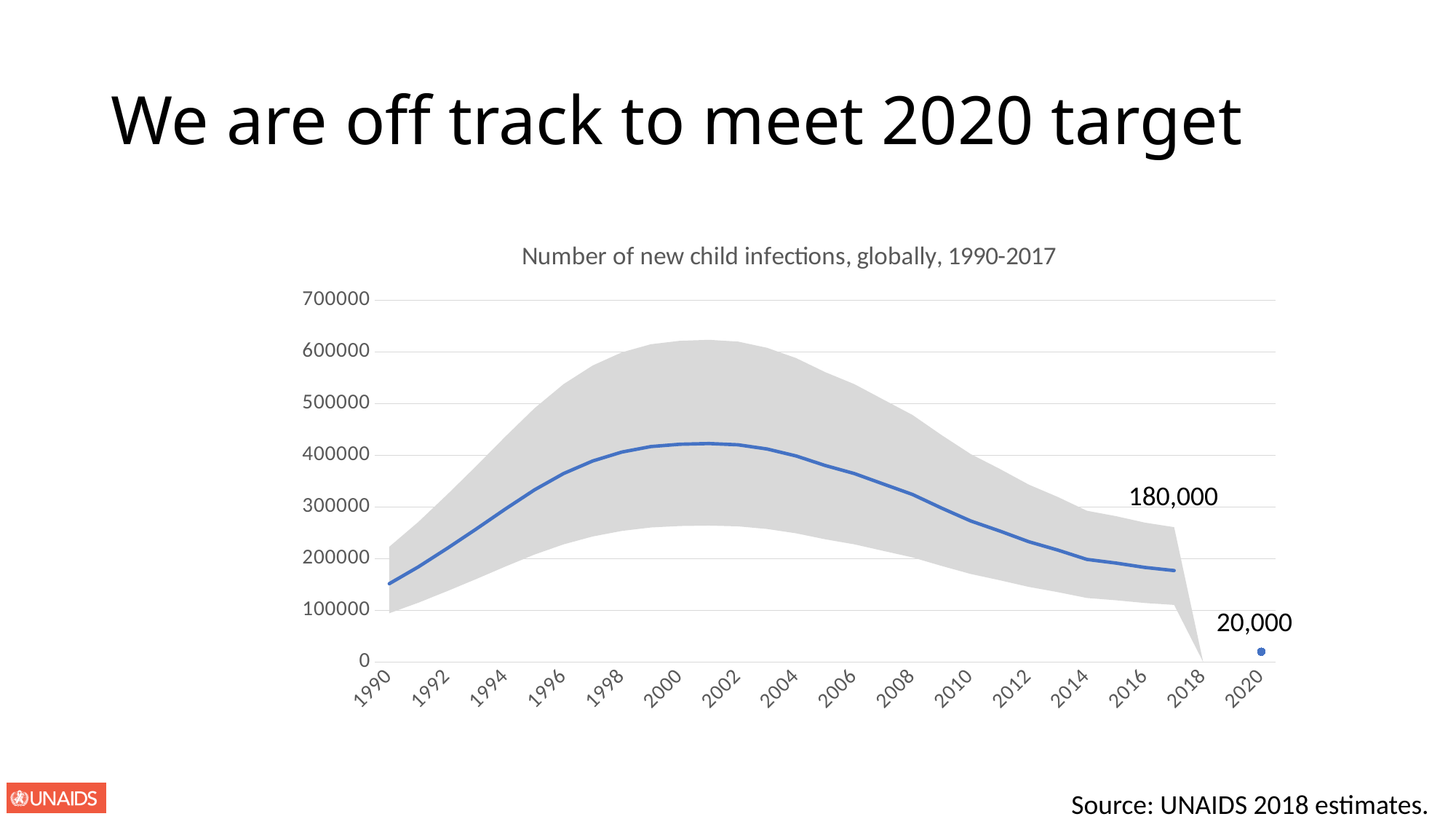
Which year has the larger value, 2000 or 2010? 2000 What is the labelled value for 2017 on the chart? 180,000 What is the title of the chart? Number of new child infections, globally, 1990-2017 What is the difference between the 2017 value (180,000) and the 2020 target (20,000)? 160,000 What is the labelled value for the 2020 target point on the chart? 20,000 Is the value for 2000 greater or less than 400000? greater What kind of chart is shown on the slide? Line chart How many year labels are shown on the x axis? 16 Is the value for 1990 greater or less than 200000? less What is the highest value shown on the y axis? 700000 Is the value for 2010 greater or less than 300000? less Does the line rise or fall between 2002 and 2017? Fall